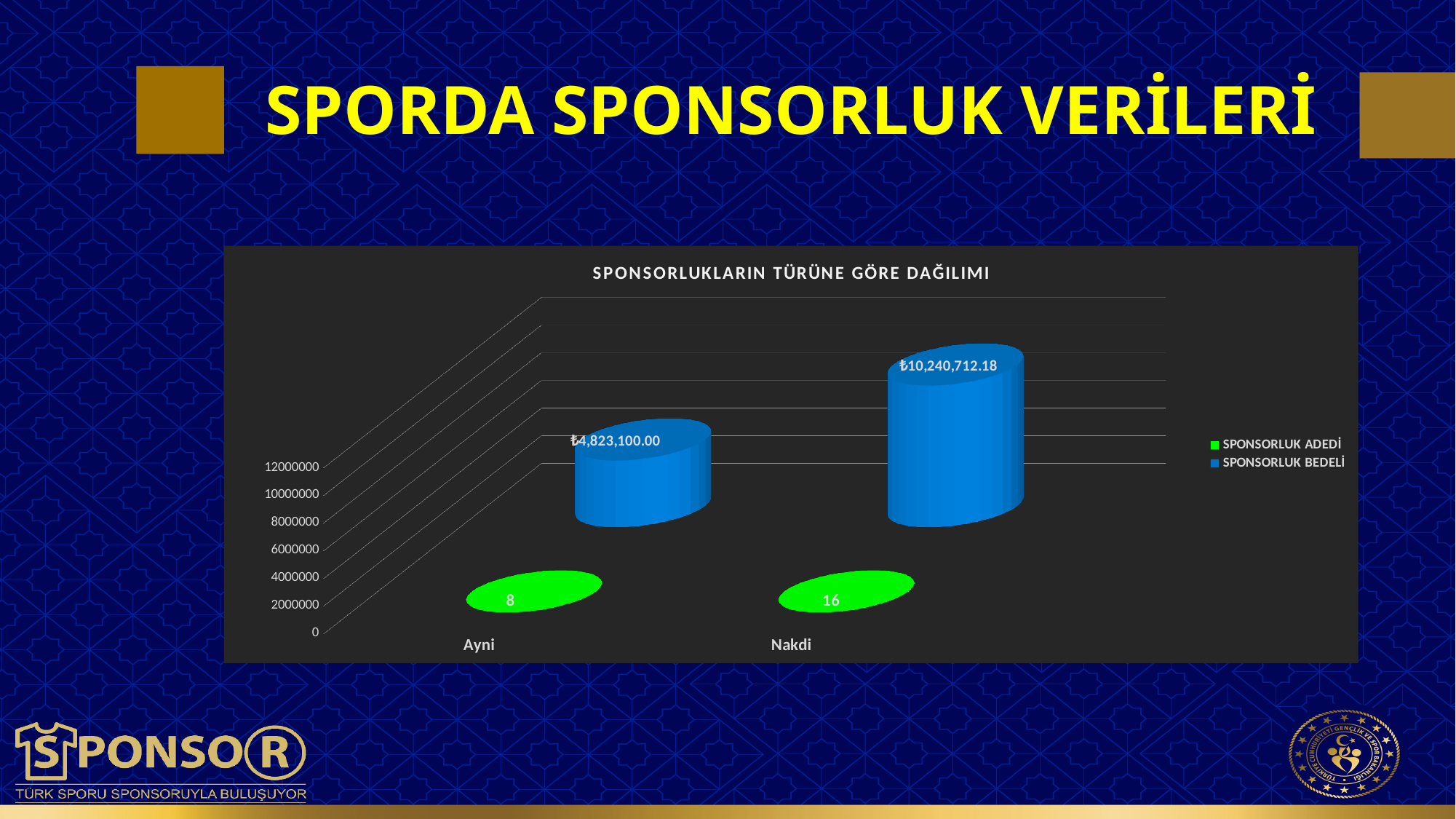
How many series does the legend list? 2 Which category has the higher SPONSORLUK BEDELİ? Nakdi Is the SPONSORLUK BEDELİ for Nakdi greater or less than 8000000? greater What is the SPONSORLUK ADEDİ value for Nakdi? 16 What is the SPONSORLUK ADEDİ value for Ayni? 8 What is the difference in SPONSORLUK ADEDİ between Nakdi and Ayni? 8 What is the SPONSORLUK BEDELİ value for Ayni? ₺4,823,100.00 Which category has the lower SPONSORLUK ADEDİ? Ayni What is the title of the chart? SPONSORLUKLARIN TÜRÜNE GÖRE DAĞILIMI How many categories are shown on the x axis? 2 What is the difference in SPONSORLUK BEDELİ between Nakdi and Ayni? ₺5,417,612.18 What is the SPONSORLUK BEDELİ value for Nakdi? ₺10,240,712.18